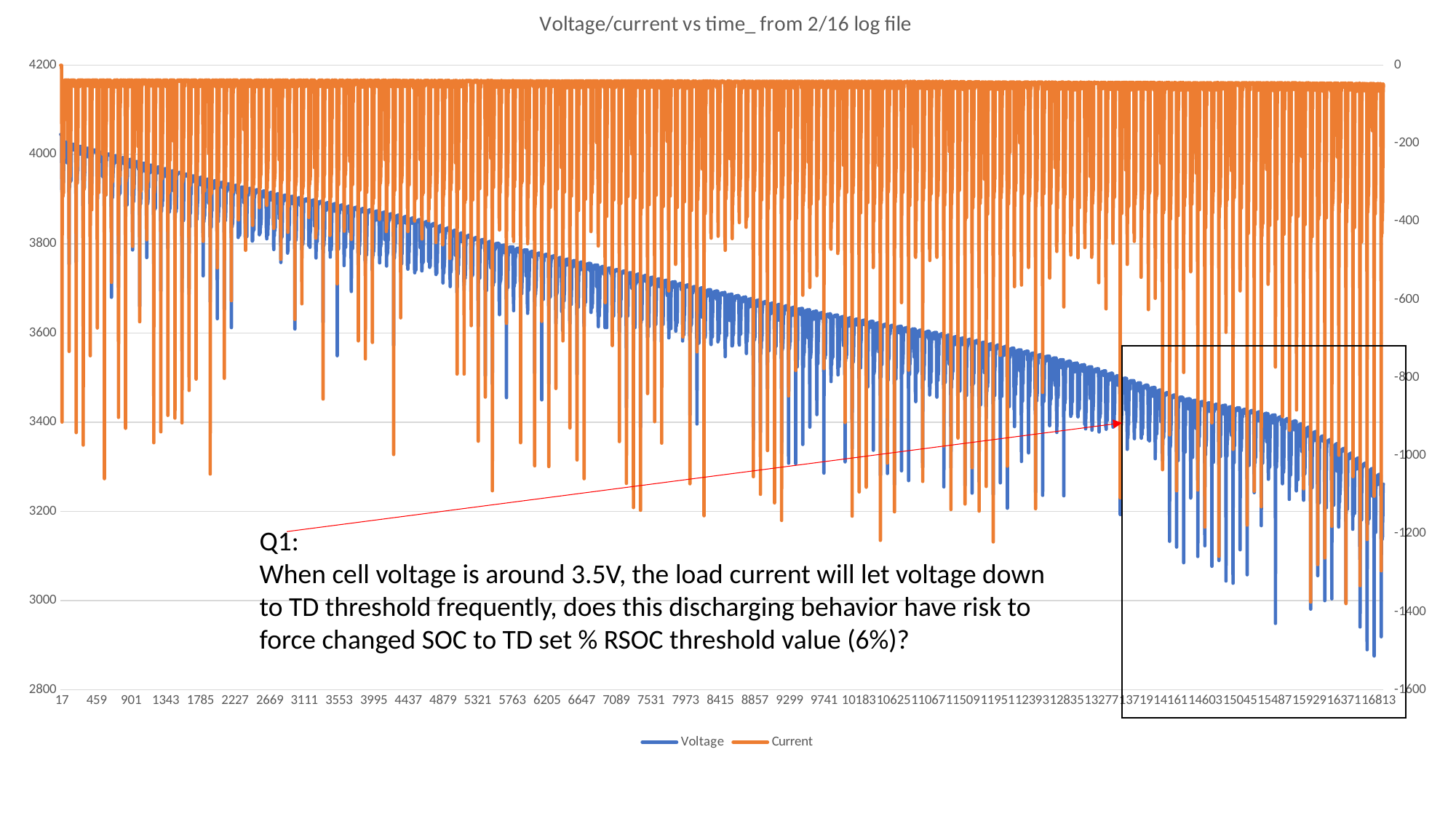
Is the highest Voltage value at the end of the chart (around x = 16813) greater or less than 3400? less Which series is drawn in blue? Voltage What is the last x-axis label on the chart? 16813 What is the title of the chart? Voltage/current vs time_ from 2/16 log file What is the minimum value shown on the right vertical axis? -1600 What kind of chart is shown on the slide? line chart What is the maximum value shown on the left vertical axis? 4200 Does the Voltage series generally rise or fall along the x axis? fall Is the Voltage value at the start of the chart (x = 17) greater or less than 3800? greater What is the first x-axis label on the chart? 17 How many series does the legend list? 2